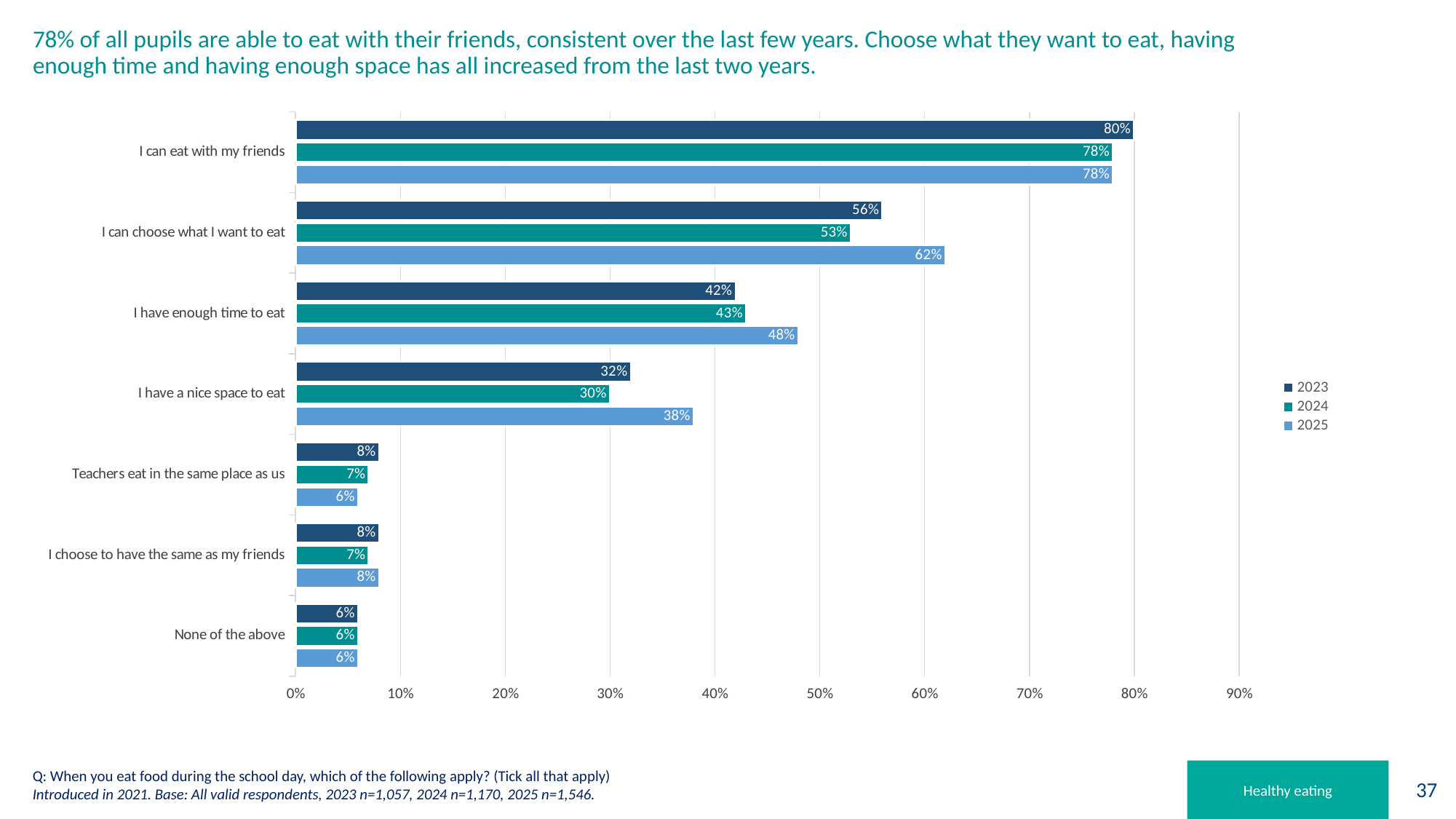
What is the difference between the 2025 and 2023 values for "I have enough time to eat"? 6% What is the 2024 value for "I have a nice space to eat"? 30% Which category has the highest value in 2025? I can eat with my friends What kind of chart is shown on the slide? Bar chart How many categories are shown on the chart? 7 What is the 2025 value for "I can choose what I want to eat"? 62% Which is larger: the 2023 value or the 2025 value for "I have a nice space to eat"? 2025 Is the 2025 value for "I have enough time to eat" greater or less than 40%? greater What is the 2023 value for "I can eat with my friends"? 80% Which category has the lowest value in 2023? None of the above What is the difference between the 2025 and 2024 values for "I can choose what I want to eat"? 9% How many series does the legend list? 3